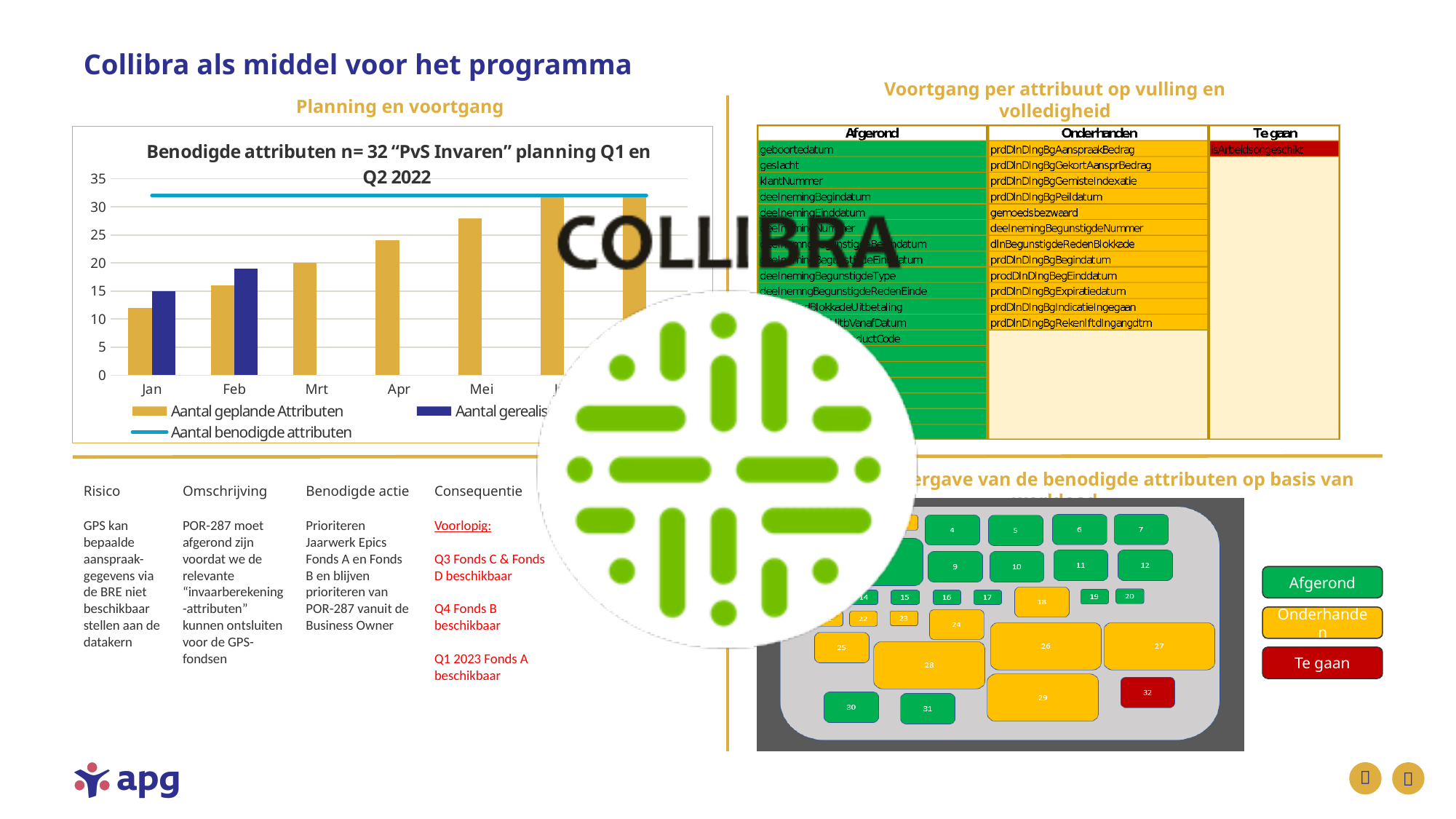
In the 'Benodigde attributen' chart, is the value for Aantal geplande Attributen in Jan greater or less than 15? less In the 'Benodigde attributen' chart, which month has the lowest value for Aantal geplande Attributen? Jan In the 'Benodigde attributen' chart, is the value for Aantal geplande Attributen in Mei greater or less than 30? less In the 'Benodigde attributen' chart, do the Aantal geplande Attributen bars rise or fall from Jan to Mei? rise In the 'Benodigde attributen' chart, is the blue bar for Jan greater or less than 10? greater What kind of chart is shown under 'Planning en voortgang'? bar and line chart In the 'Benodigde attributen' chart, which is larger for Jan: the gold bar (Aantal geplande Attributen) or the blue bar? the blue bar In the 'Benodigde attributen' chart, what colour are the Aantal geplande Attributen bars? gold What is the title of the chart under 'Planning en voortgang'? Benodigde attributen n= 32 "PvS Invaren" planning Q1 en Q2 2022